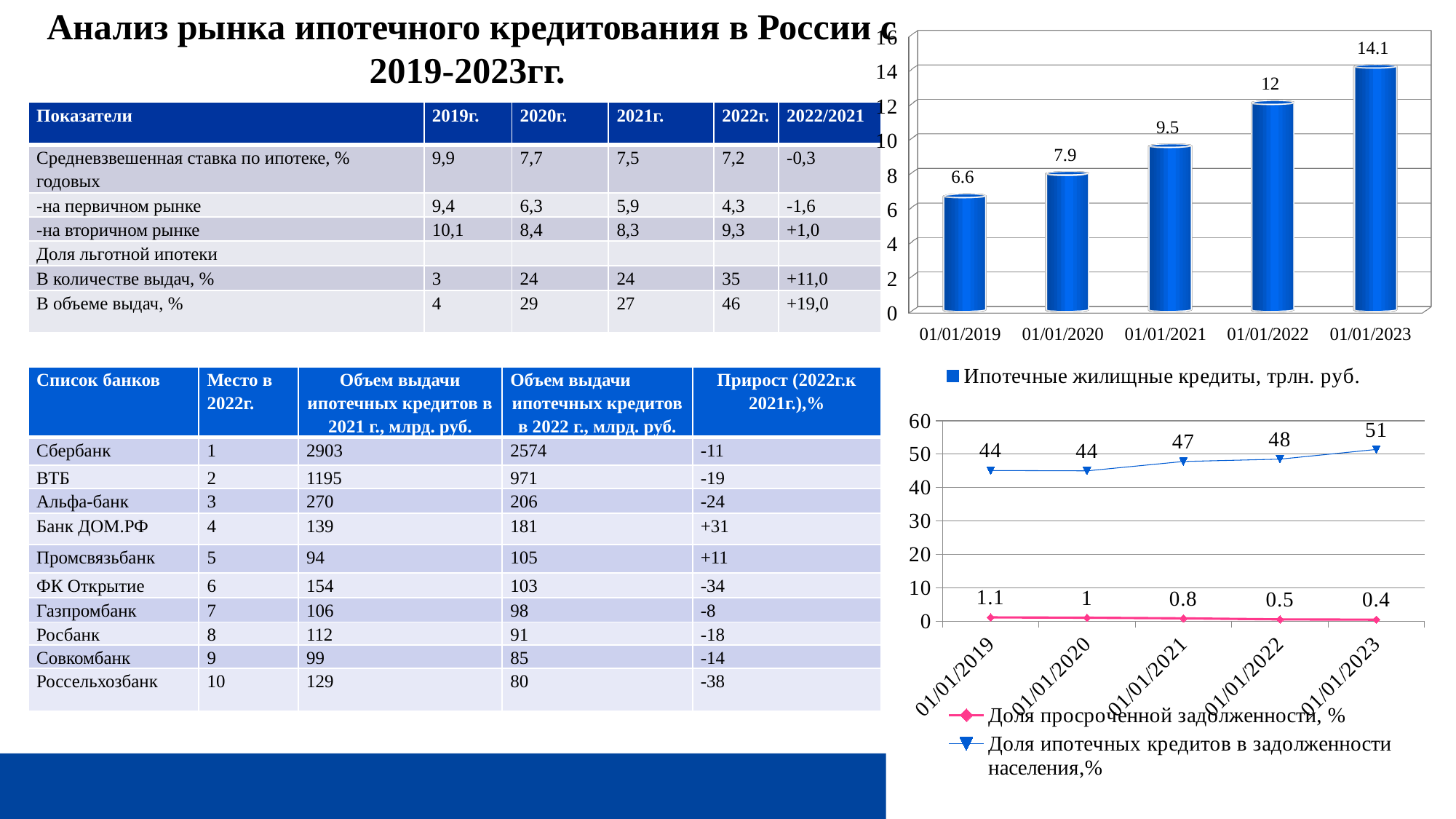
In the top-right bar chart, do the values rise or fall from 01/01/2019 to 01/01/2023? rise In the bottom-right line chart, does 'Доля просроченной задолженности, %' rise or fall from 01/01/2019 to 01/01/2023? fall In the bottom-right line chart, what is the difference between the 'Доля ипотечных кредитов в задолженности населения,%' values for 01/01/2023 and 01/01/2019? 7 In the bottom-right line chart, what is the value of 'Доля ипотечных кредитов в задолженности населения,%' for 01/01/2023? 51 In the top-right bar chart, what is the value for 01/01/2020? 7.9 How many series does the legend of the bottom-right line chart list? 2 What type of chart is the top-right chart? bar chart How many bars are in the top-right bar chart? 5 In the top-right bar chart, which date has the lowest value? 01/01/2019 In the top-right bar chart, what is the difference between the values for 01/01/2023 and 01/01/2019? 7.5 In the top-right bar chart, what is the value for 01/01/2023? 14.1 In the bottom-right line chart, what is the value of 'Доля просроченной задолженности, %' for 01/01/2021? 0.8